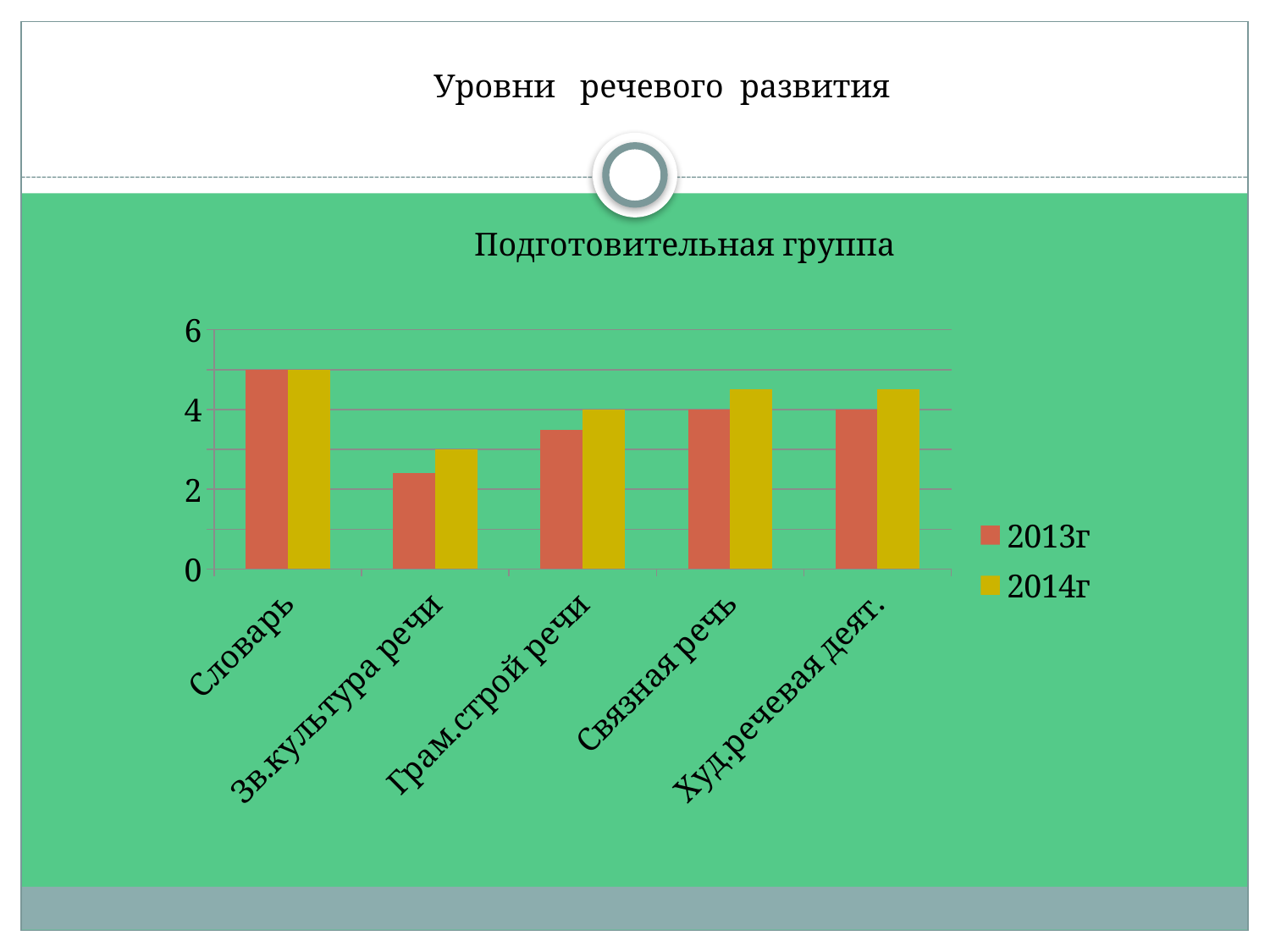
How many categories are shown on the x axis of the chart? 5 Is the value for Зв.культура речи in the 2013г series greater or less than 4? less How many series does the chart's legend list? 2 What is the value for Грам.строй речи in the 2014г series? 4 What is the value for Худ.речевая деят. in the 2013г series? 4 What are the two entries listed in the chart's legend? 2013г and 2014г Which category has the lowest value in the 2014г series? Зв.культура речи What is the value for Связная речь in the 2013г series? 4 Which category has the highest value in the 2013г series? Словарь What kind of chart is shown on the slide? bar chart In the 2013г series, which is larger: the value for Словарь or the value for Зв.культура речи? Словарь Is the value for Словарь in the 2014г series greater or less than 4? greater